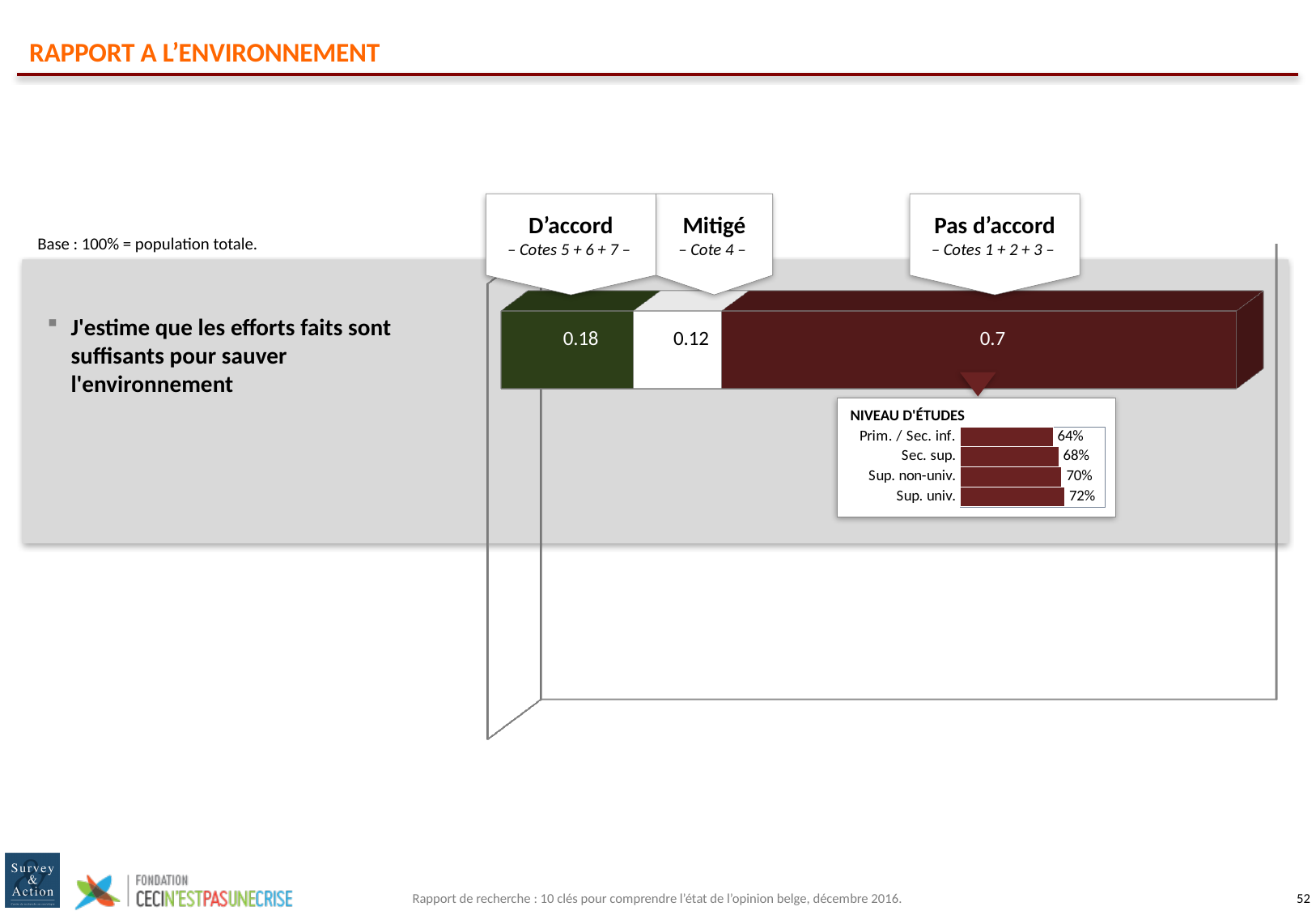
In the main stacked bar chart, which segment has the lowest value? Mitigé In the "NIVEAU D'ÉTUDES" chart, which category has the lowest value? Prim. / Sec. inf. In the "NIVEAU D'ÉTUDES" chart, what is the difference between "Sup. univ." and "Prim. / Sec. inf."? 8% In the "NIVEAU D'ÉTUDES" chart, what is the value for "Sec. sup."? 68% What kind of chart is the "NIVEAU D'ÉTUDES" chart? Bar chart In the main stacked bar chart, what is the value for "D'accord"? 0.18 In the main stacked bar chart, how many segments make up the bar? 3 In the main stacked bar chart, which segment has the highest value? Pas d'accord In the main stacked bar chart, what is the value for "Pas d'accord"? 0.7 In the main stacked bar chart, what is the value for "Mitigé"? 0.12 In the main stacked bar chart, what is the difference between the "Pas d'accord" and "D'accord" values? 0.52 In the "NIVEAU D'ÉTUDES" chart, which category has the highest value? Sup. univ.